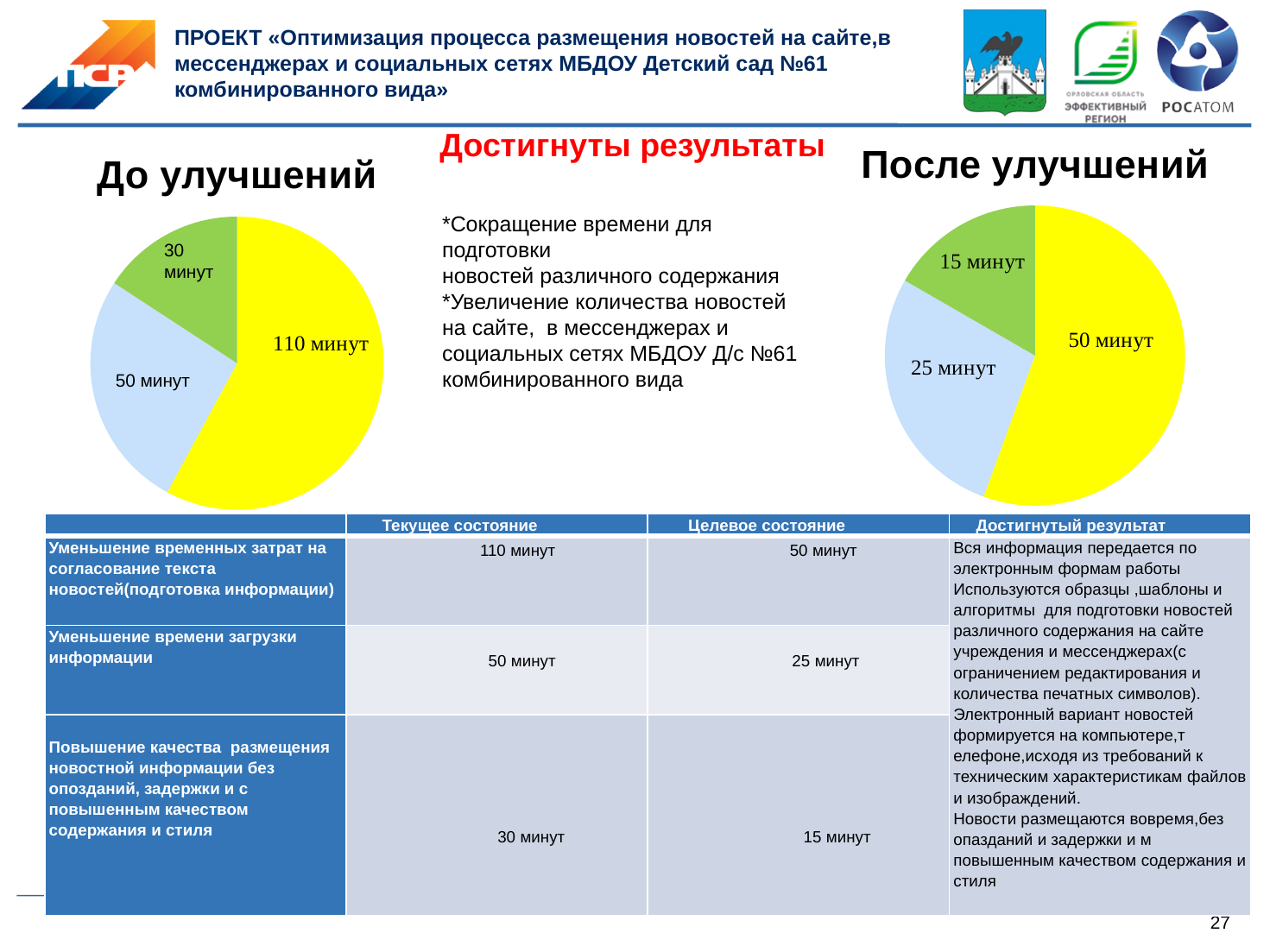
In the "После улучшений" pie chart, which slice value is the largest? 50 минут In the "До улучшений" pie chart, which slice value is the smallest? 30 минут What kind of chart is the "До улучшений" chart? pie chart In the "После улучшений" pie chart, what value is shown on the light blue slice? 25 минут In the "После улучшений" pie chart, what is the difference between the yellow slice (50 минут) and the green slice (15 минут)? 35 минут In the "До улучшений" pie chart, what is the difference between the yellow slice (110 минут) and the light blue slice (50 минут)? 60 минут What is the total of all slices in the "После улучшений" pie chart? 90 минут How many slices does the "После улучшений" pie chart have? 3 What is the total of all slices in the "До улучшений" pie chart? 190 минут Which is larger: the yellow slice in the "До улучшений" chart or the yellow slice in the "После улучшений" chart? the yellow slice in "До улучшений" (110 минут) In the "До улучшений" pie chart, what value is shown on the green slice? 30 минут In the "До улучшений" pie chart, what value is shown on the largest (yellow) slice? 110 минут